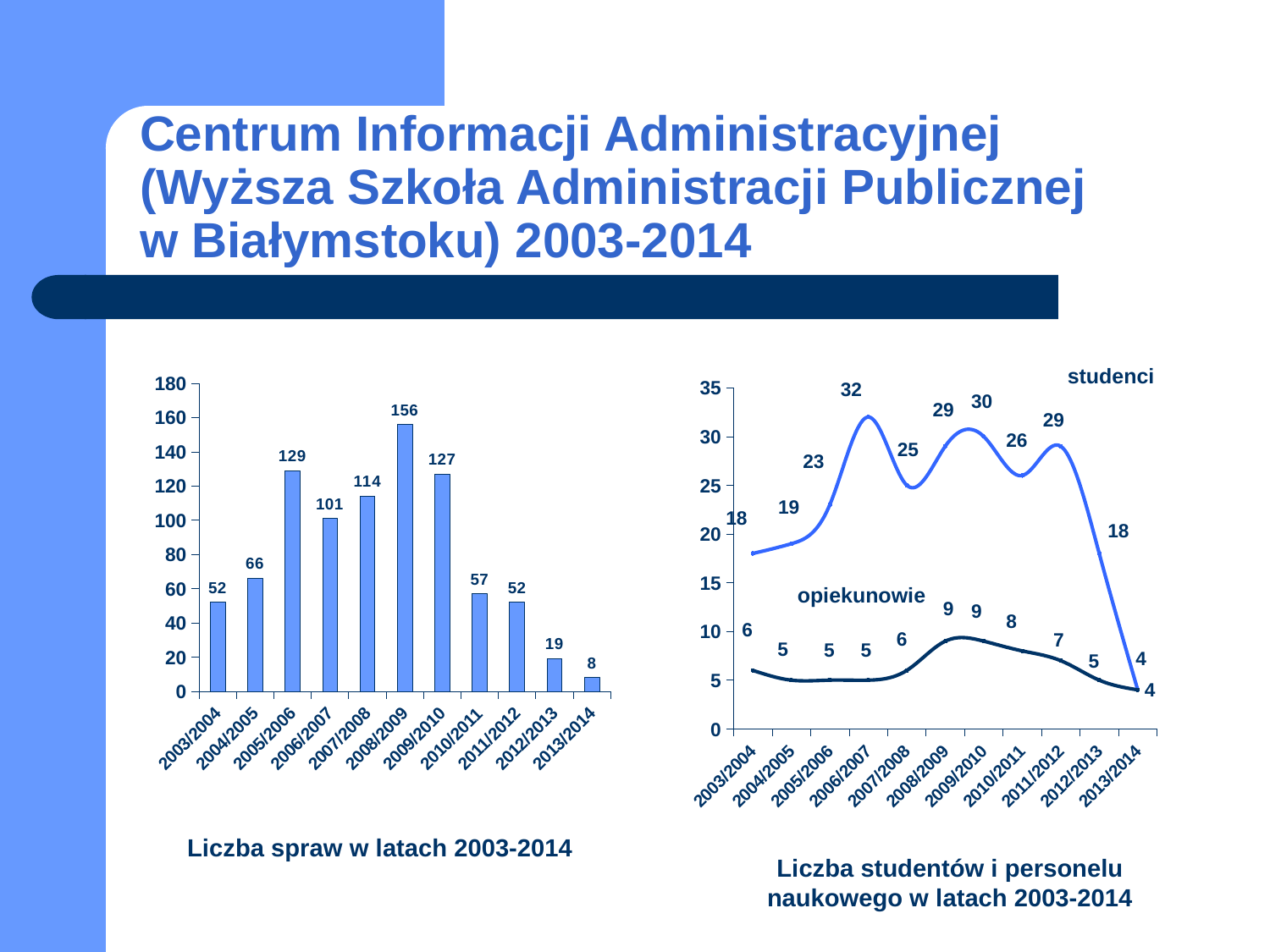
In the chart 'Liczba spraw w latach 2003-2014', what is the value for 2008/2009? 156 What kind of chart is 'Liczba studentów i personelu naukowego w latach 2003-2014'? line chart In the chart 'Liczba spraw w latach 2003-2014', which year has the highest value? 2008/2009 In the chart 'Liczba spraw w latach 2003-2014', which year has the lowest value? 2013/2014 In the chart 'Liczba spraw w latach 2003-2014', how many years are shown on the x axis? 11 In the chart 'Liczba studentów i personelu naukowego w latach 2003-2014', do the studenci values rise or fall from 2011/2012 to 2013/2014? fall In the chart 'Liczba studentów i personelu naukowego w latach 2003-2014', which is larger in 2009/2010: studenci or opiekunowie? studenci In the chart 'Liczba studentów i personelu naukowego w latach 2003-2014', what is the value for studenci in 2006/2007? 32 What kind of chart is 'Liczba spraw w latach 2003-2014'? bar chart In the chart 'Liczba spraw w latach 2003-2014', what is the difference between the values for 2005/2006 and 2006/2007? 28 In the chart 'Liczba studentów i personelu naukowego w latach 2003-2014', what is the value for opiekunowie in 2010/2011? 8 In the chart 'Liczba studentów i personelu naukowego w latach 2003-2014', what is the difference between studenci and opiekunowie in 2013/2014? 0